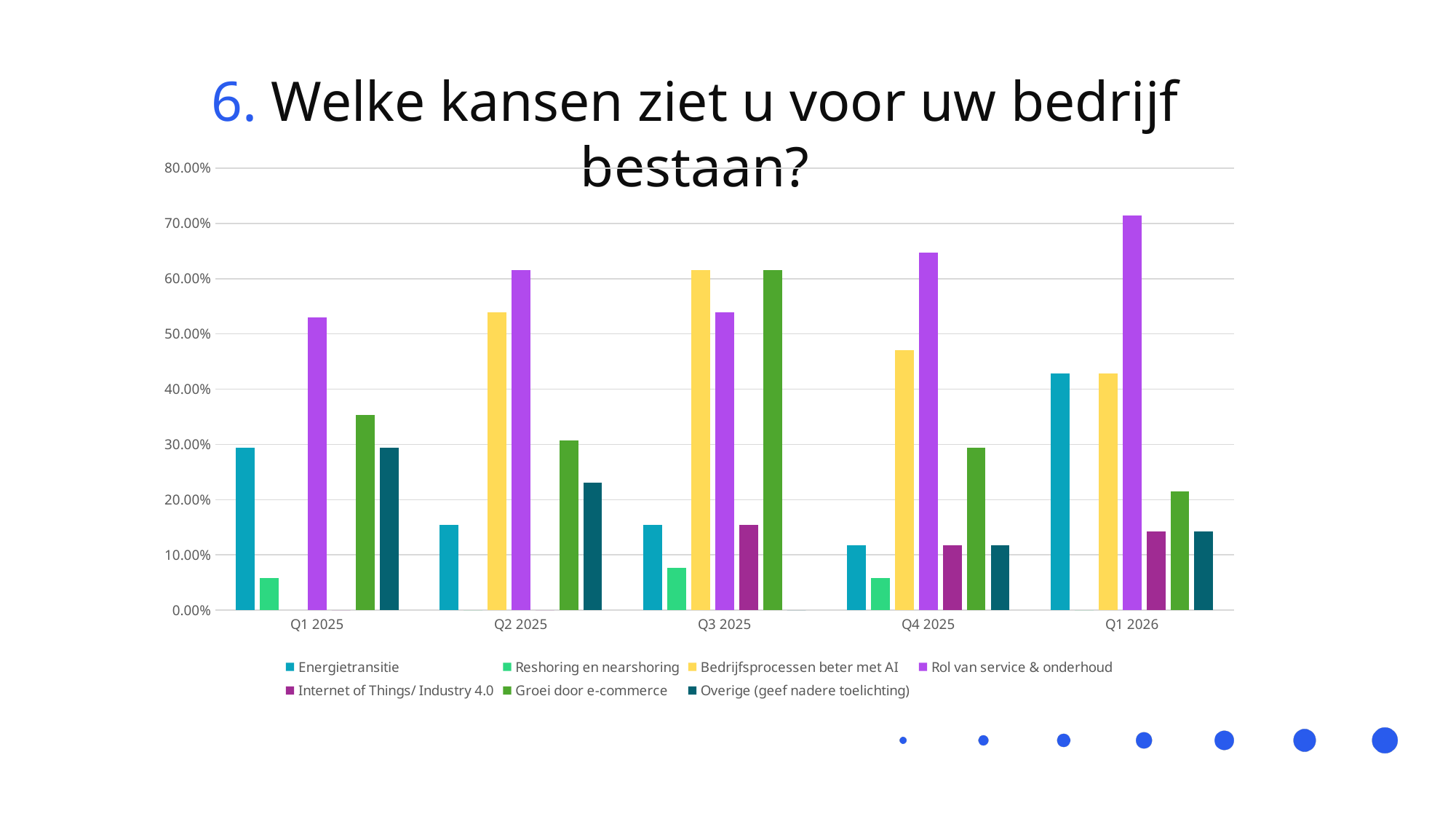
Is the value for Rol van service & onderhoud in Q1 2026 greater or less than 60.00%? greater In Q1 2026, which series has the highest bar? Rol van service & onderhoud Is the value for Reshoring en nearshoring in Q1 2025 greater or less than 10.00%? less Which series and quarter has the tallest bar in the whole chart? Rol van service & onderhoud in Q1 2026 How many series does the legend list? 7 How many quarters are shown on the x axis? 5 Does the value for Rol van service & onderhoud rise or fall from Q3 2025 to Q1 2026? rise In Q2 2025, which is larger: Bedrijfsprocessen beter met AI or Rol van service & onderhoud? Rol van service & onderhoud What kind of chart is shown on the slide? Bar chart In Q4 2025, which series has the lowest bar? Reshoring en nearshoring Is the value for Groei door e-commerce in Q3 2025 greater or less than 50.00%? greater